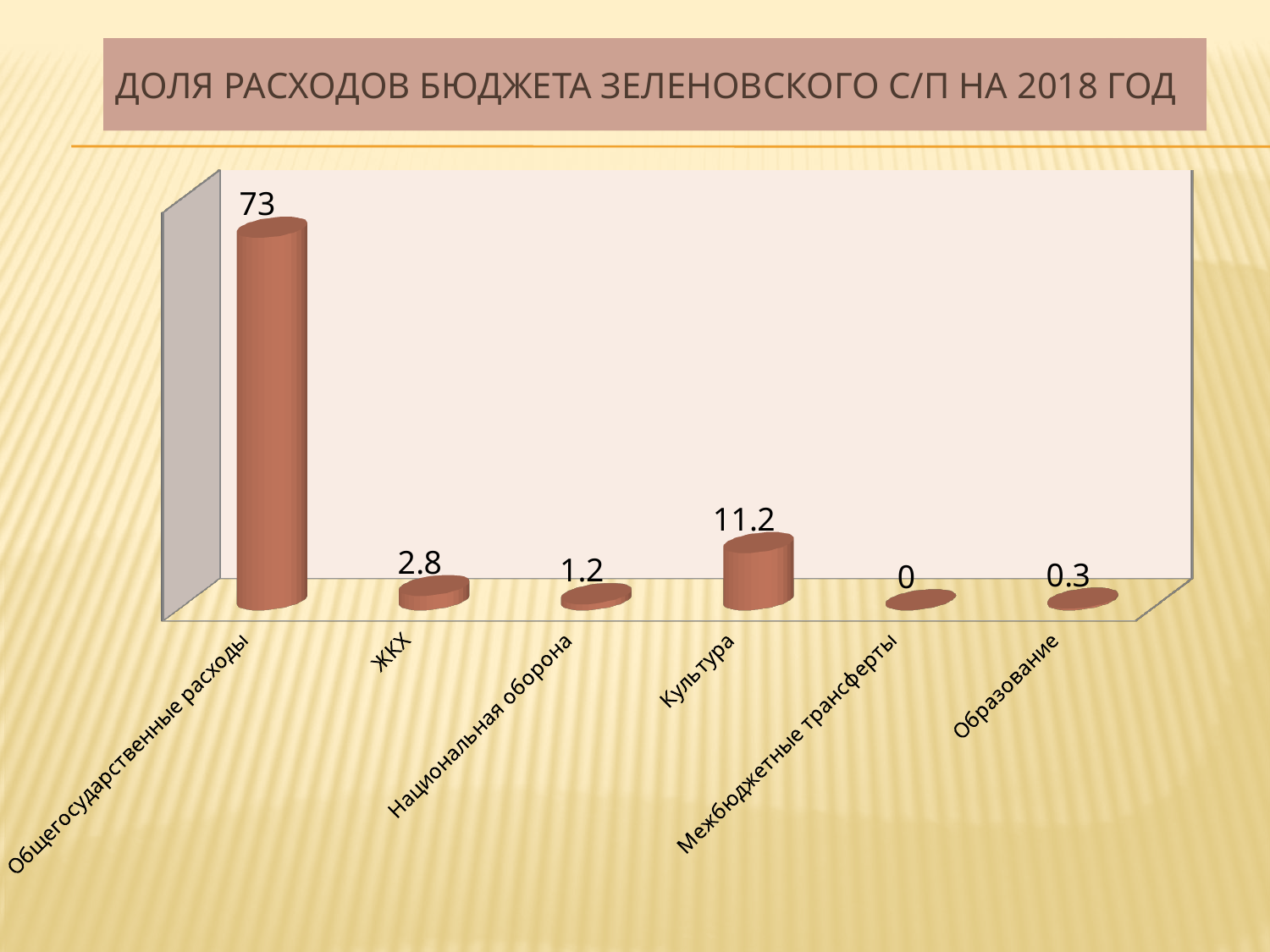
How many categories are shown on the chart? 6 What kind of chart is shown on the slide? Bar chart What is the value for Образование? 0.3 What is the difference between the values for Общегосударственные расходы and Культура? 61.8 What is the value for Общегосударственные расходы? 73 What is the value for Национальная оборона? 1.2 Which category has the lowest value? Межбюджетные трансферты What is the value for ЖКХ? 2.8 Which category has the highest value? Общегосударственные расходы Which is larger, the value for ЖКХ or the value for Национальная оборона? ЖКХ What is the title of the chart? ДОЛЯ РАСХОДОВ БЮДЖЕТА ЗЕЛЕНОВСКОГО С/П НА 2018 ГОД What is the value for Культура? 11.2